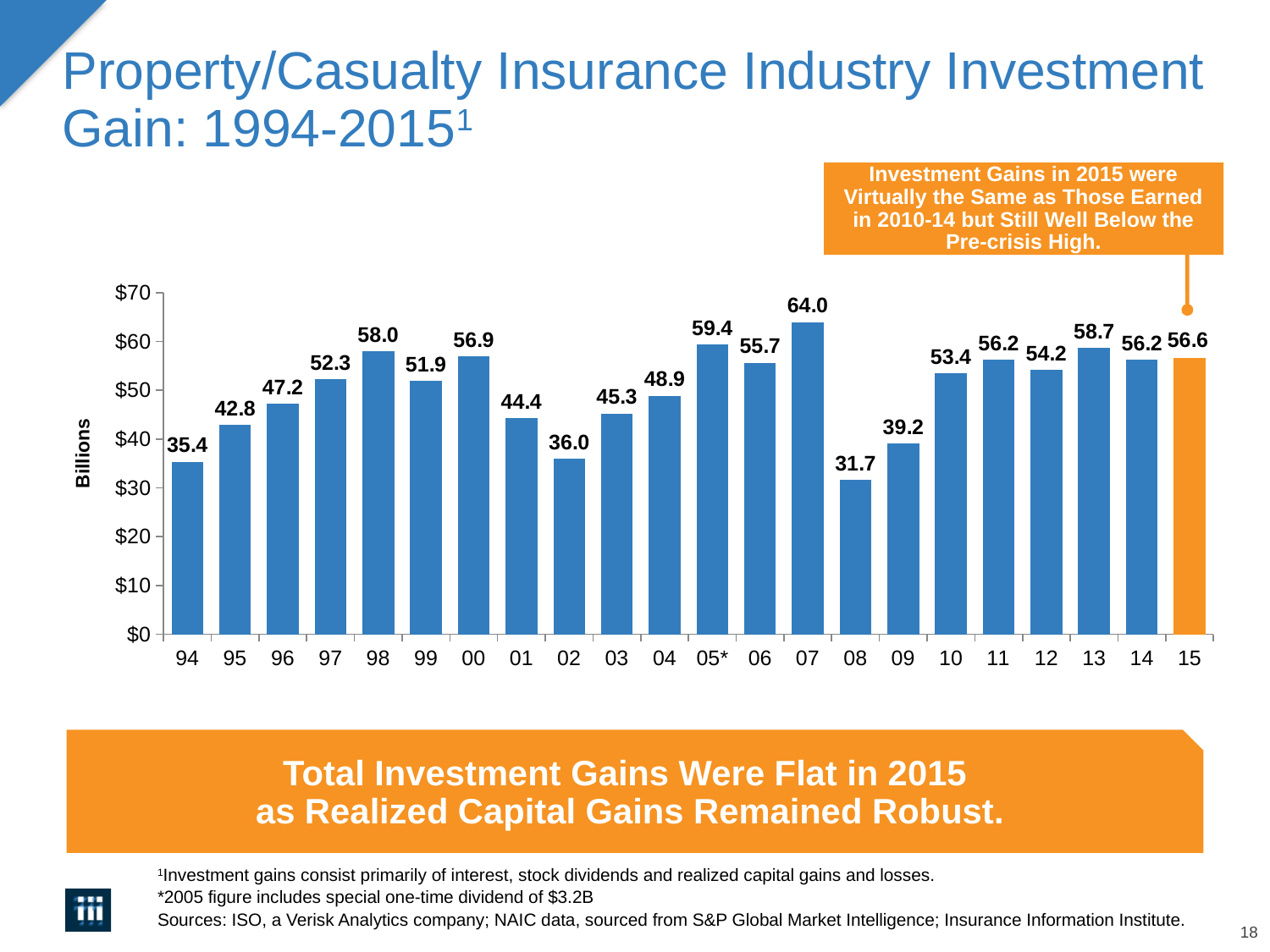
What is the difference between the 2007 value and the 2008 value? 32.3 What is the investment gain value shown for 2015? 56.6 What is the investment gain value shown for 2007? 64.0 What kind of chart is shown on the slide? bar chart Is the value for 2002 greater or less than $40? less What is the investment gain value shown for 1994? 35.4 Which year has the lowest investment gain on the chart? 08 What is the label on the vertical axis of the chart? Billions How many years are plotted on the chart? 22 Which year has the highest investment gain on the chart? 07 Which is larger, the value for 2013 or the value for 2014? 2013 Do the values rise or fall from 1994 to 1998? rise